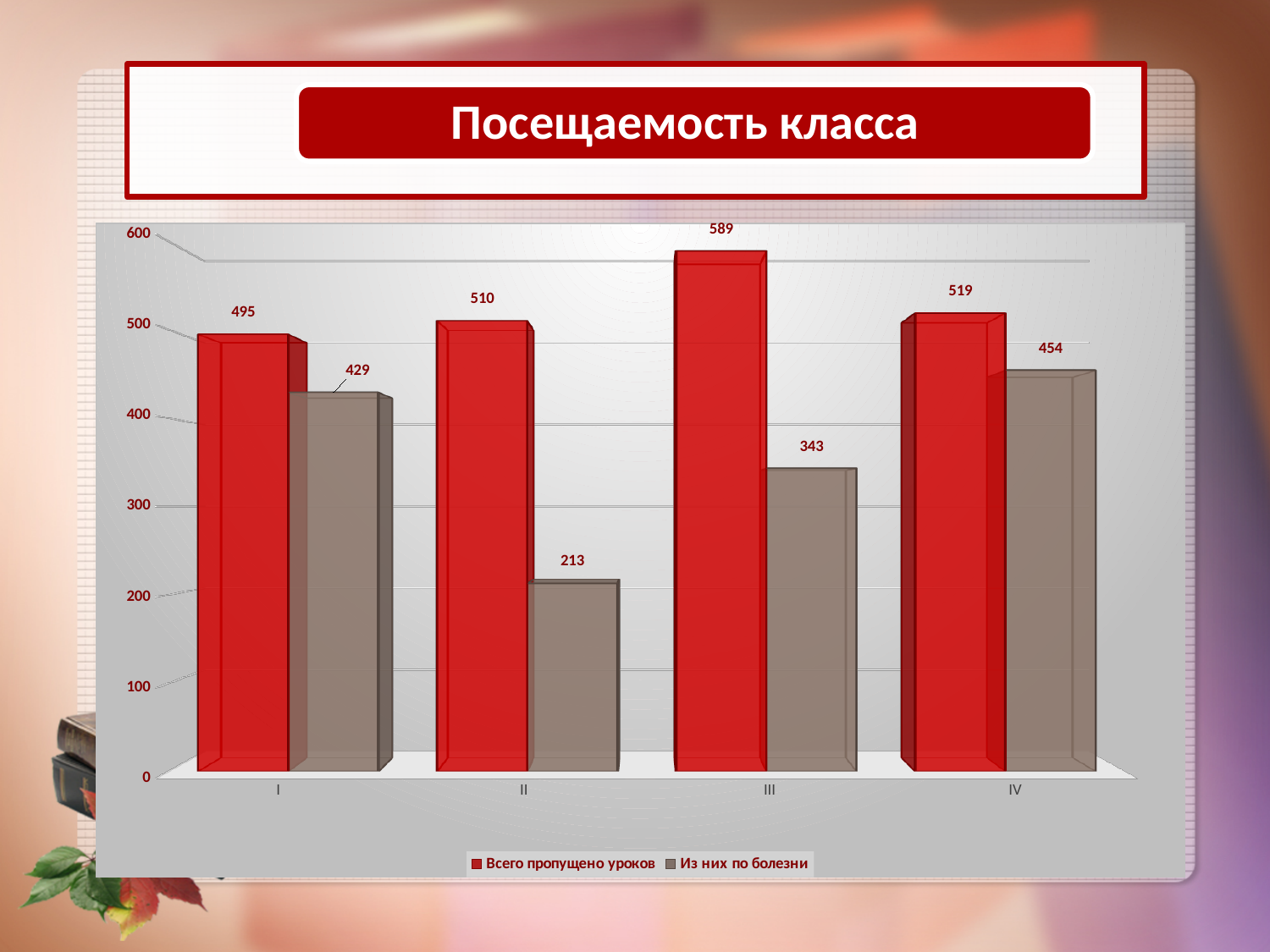
What is the difference between "Всего пропущено уроков" and "Из них по болезни" for category II? 297 What is the difference between "Всего пропущено уроков" for category III and category I? 94 Which category has the highest value for "Всего пропущено уроков"? III How many series does the legend list? 2 How many categories are shown on the x axis? 4 What is the value of "Всего пропущено уроков" for category III? 589 What kind of chart is shown on the slide? Bar chart What is the value of "Из них по болезни" for category II? 213 Which category has the lowest value for "Из них по болезни"? II Which is larger: "Из них по болезни" for category I or for category IV? IV What is the value of "Из них по болезни" for category IV? 454 What is the title of the slide? Посещаемость класса